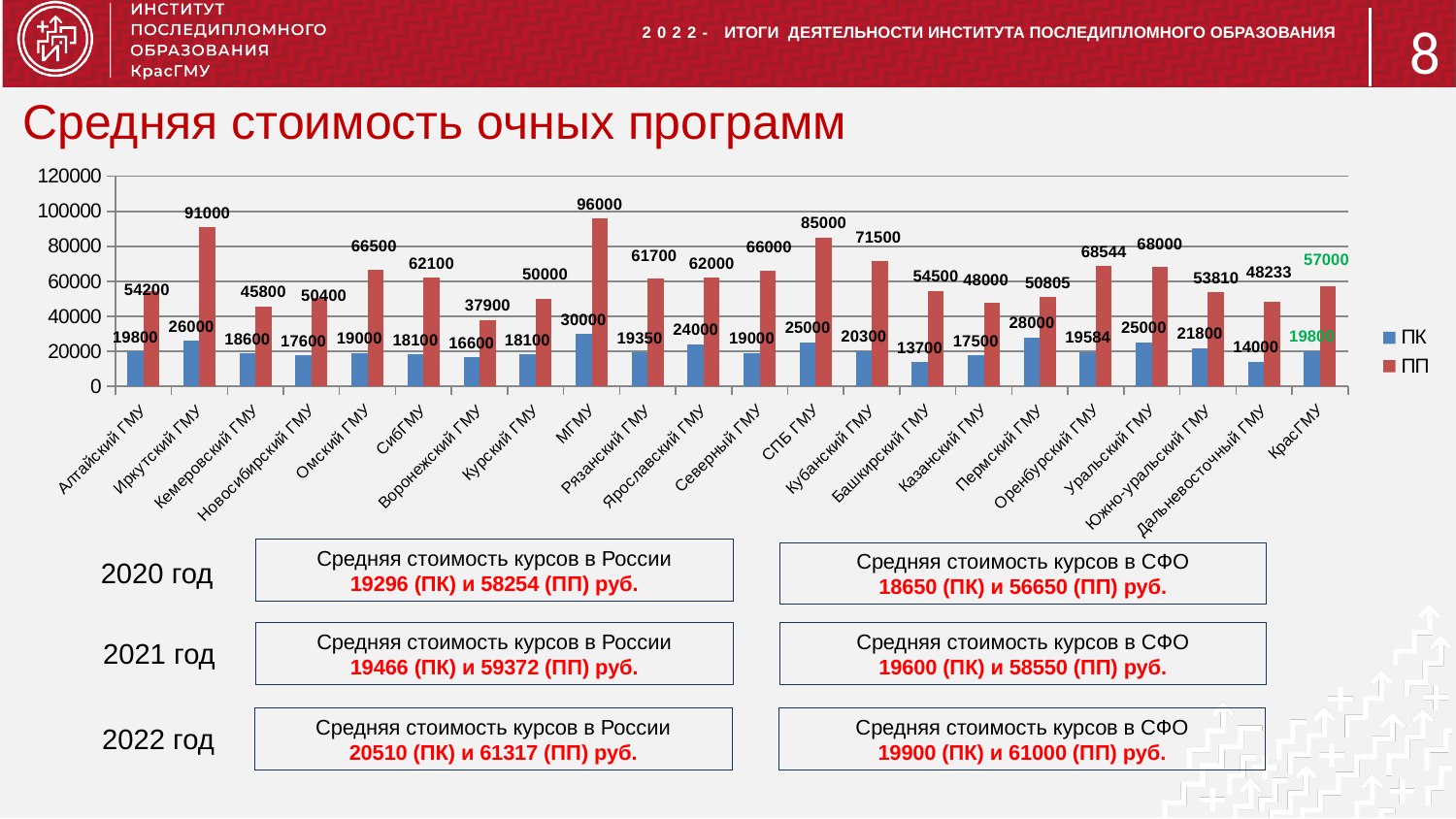
Which is larger: the ПП value for СПБ ГМУ or the ПП value for Кубанский ГМУ? СПБ ГМУ What is the ПК value for КрасГМУ? 19800 Which category has the lowest ПП value? Воронежский ГМУ How many series does the legend list? 2 What kind of chart is shown on the slide? Bar chart Which category has the highest ПП value? МГМУ What is the ПП value for Оренбургский ГМУ? 68544 How many categories are shown on the x axis? 22 What is the difference between the ПП and ПК values for МГМУ? 66000 What is the ПП value for Иркутский ГМУ? 91000 What is the title of the chart? Средняя стоимость очных программ Which category has the lowest ПК value? Башкирский ГМУ